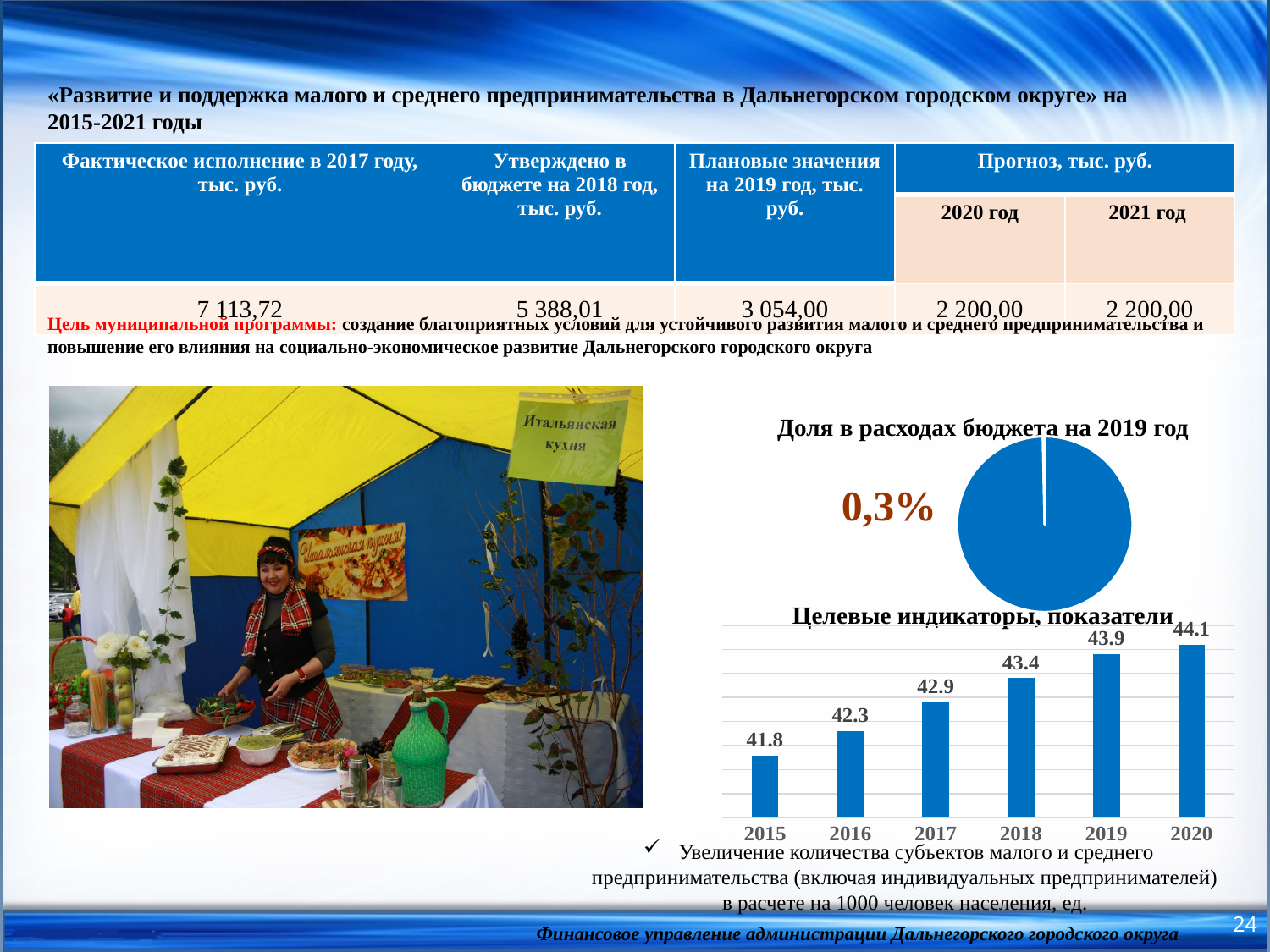
In the chart titled "Целевые индикаторы, показатели", which is larger, the value for 2019 or the value for 2017? 2019 In the chart titled "Целевые индикаторы, показатели", which year has the highest value? 2020 In the chart titled "Целевые индикаторы, показатели", what is the value for 2020? 44.1 How many years are shown on the x axis of the chart titled "Целевые индикаторы, показатели"? 6 In the chart titled "Целевые индикаторы, показатели", what is the value for 2015? 41.8 In the chart titled "Целевые индикаторы, показатели", do the values rise or fall from 2015 to 2020? rise In the chart titled "Целевые индикаторы, показатели", what is the value for 2018? 43.4 In the chart titled "Целевые индикаторы, показатели", what is the difference between the values for 2017 and 2016? 0.6 In the chart titled "Целевые индикаторы, показатели", which year has the lowest value? 2015 What kind of chart is the one titled "Целевые индикаторы, показатели"? bar chart What share is shown in the pie chart titled "Доля в расходах бюджета на 2019 год"? 0,3% In the chart titled "Целевые индикаторы, показатели", what is the difference between the values for 2020 and 2015? 2.3